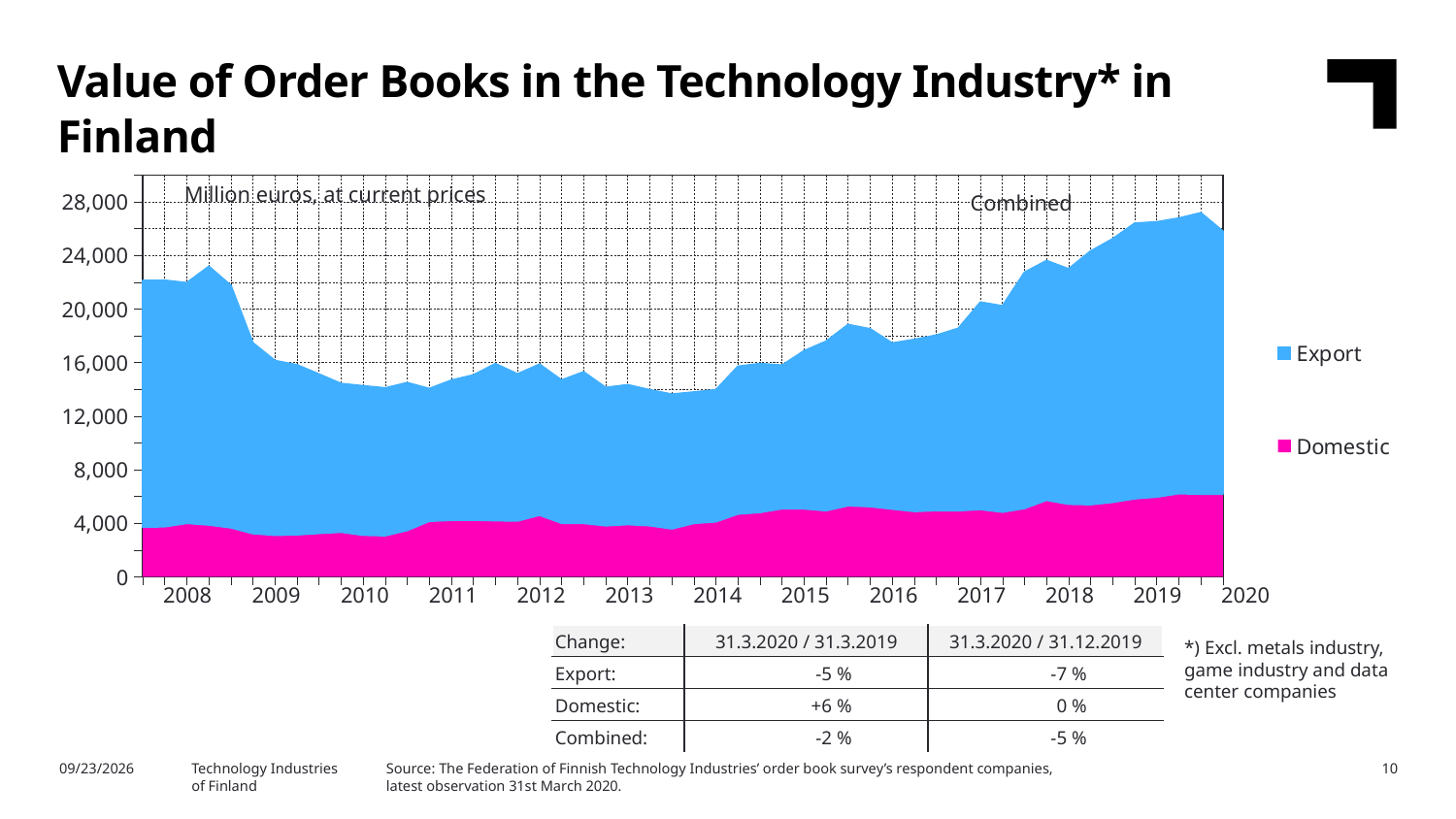
Is the combined value of order books at the start of 2008 greater or less than 20,000? greater Is the Domestic value in 2019 greater or less than 4,000? greater Does the combined value of order books rise or fall between 2008 and 2009? fall Is the combined value of order books at its 2019 peak greater or less than 24,000? greater What kind of chart is shown on the slide? Area chart Which series is larger throughout the chart, Export or Domestic? Export Does the combined value of order books rise or fall between 2016 and 2019? rise How many series does the chart legend list? 2 Which two series are listed in the chart legend? Export and Domestic What unit is stated for the values in the chart? Million euros, at current prices